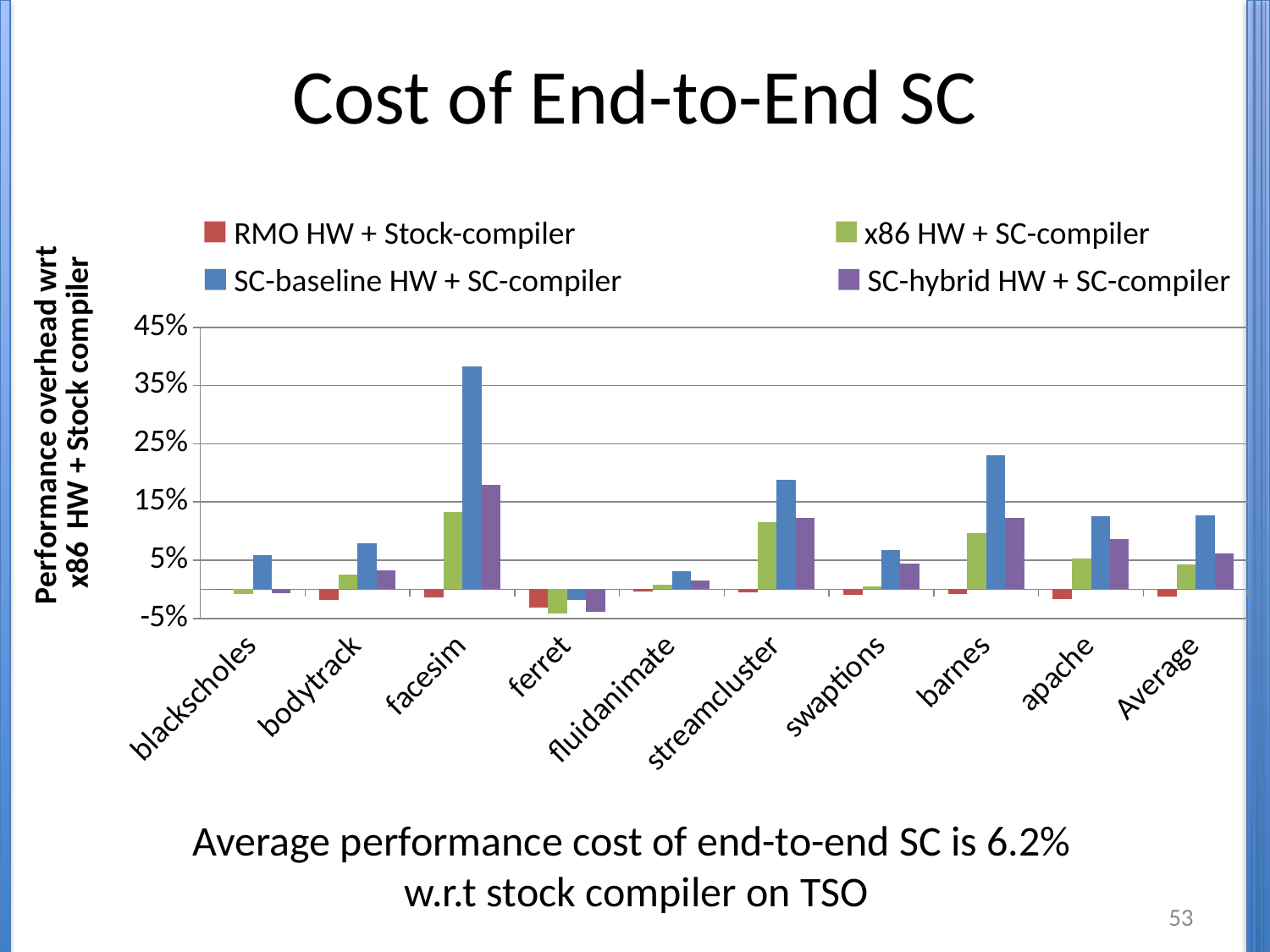
Is the SC-baseline HW + SC-compiler value for barnes greater or less than 15%? greater What kind of chart is shown on the slide? bar chart Is the SC-baseline HW + SC-compiler value for Average greater or less than 15%? less For the SC-baseline HW + SC-compiler series, which is larger: barnes or apache? barnes How many series does the legend list? 4 Which category has the highest value for the SC-baseline HW + SC-compiler series? facesim Is the SC-hybrid HW + SC-compiler value for streamcluster greater or less than 5%? greater For facesim, which is larger: the SC-baseline HW + SC-compiler value or the SC-hybrid HW + SC-compiler value? SC-baseline HW + SC-compiler How many categories are shown along the x axis? 10 What is the title of the chart? Cost of End-to-End SC Which series is shown in green in the legend? x86 HW + SC-compiler